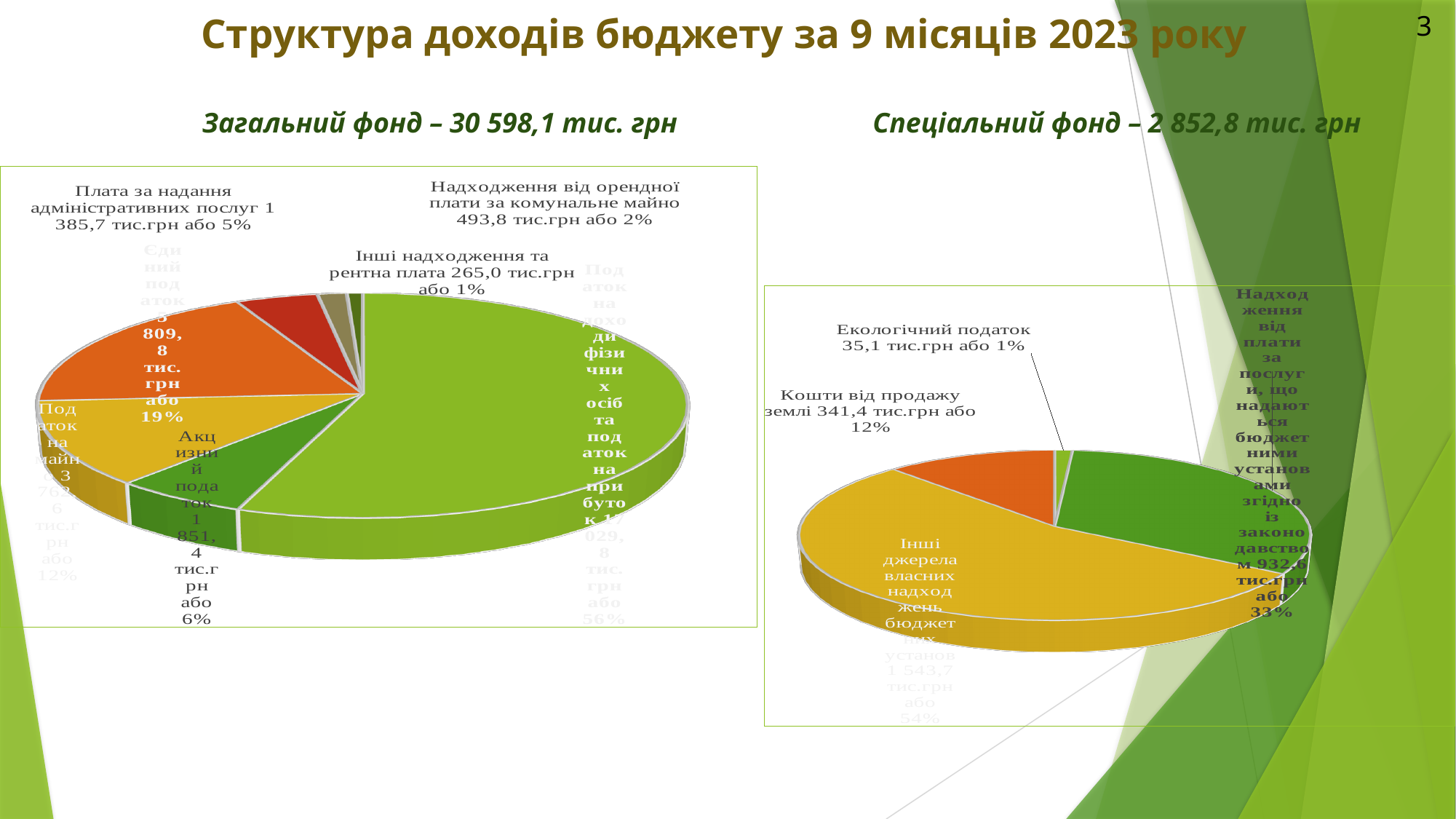
In the Загальний фонд chart, what is the value for Плата за надання адміністративних послуг? 1 385,7 тис.грн In the Загальний фонд chart, what share does Надходження від орендної плати за комунальне майно have? 2% What kind of chart is used for the Загальний фонд (left chart)? pie chart In the Загальний фонд chart, what is the value for Інші надходження та рентна плата? 265,0 тис.грн In the Спеціальний фонд chart (right), what is the value for Екологічний податок? 35,1 тис.грн In the Загальний фонд chart, what is the value for Акцизний податок? 1 851,4 тис.грн In the Загальний фонд chart, what is the difference between Плата за надання адміністративних послуг and Надходження від орендної плати за комунальне майно? 891,9 тис.грн In the Загальний фонд chart, which is larger: Єдиний податок or Акцизний податок? Єдиний податок What total is given for the Спеціальний фонд in the heading above the right chart? 2 852,8 тис. грн In the Загальний фонд chart, what share does Єдиний податок have? 19% In the Спеціальний фонд chart (right), how many slices does the pie have? 4 In the Спеціальний фонд chart (right), what share does Кошти від продажу землі have? 12%